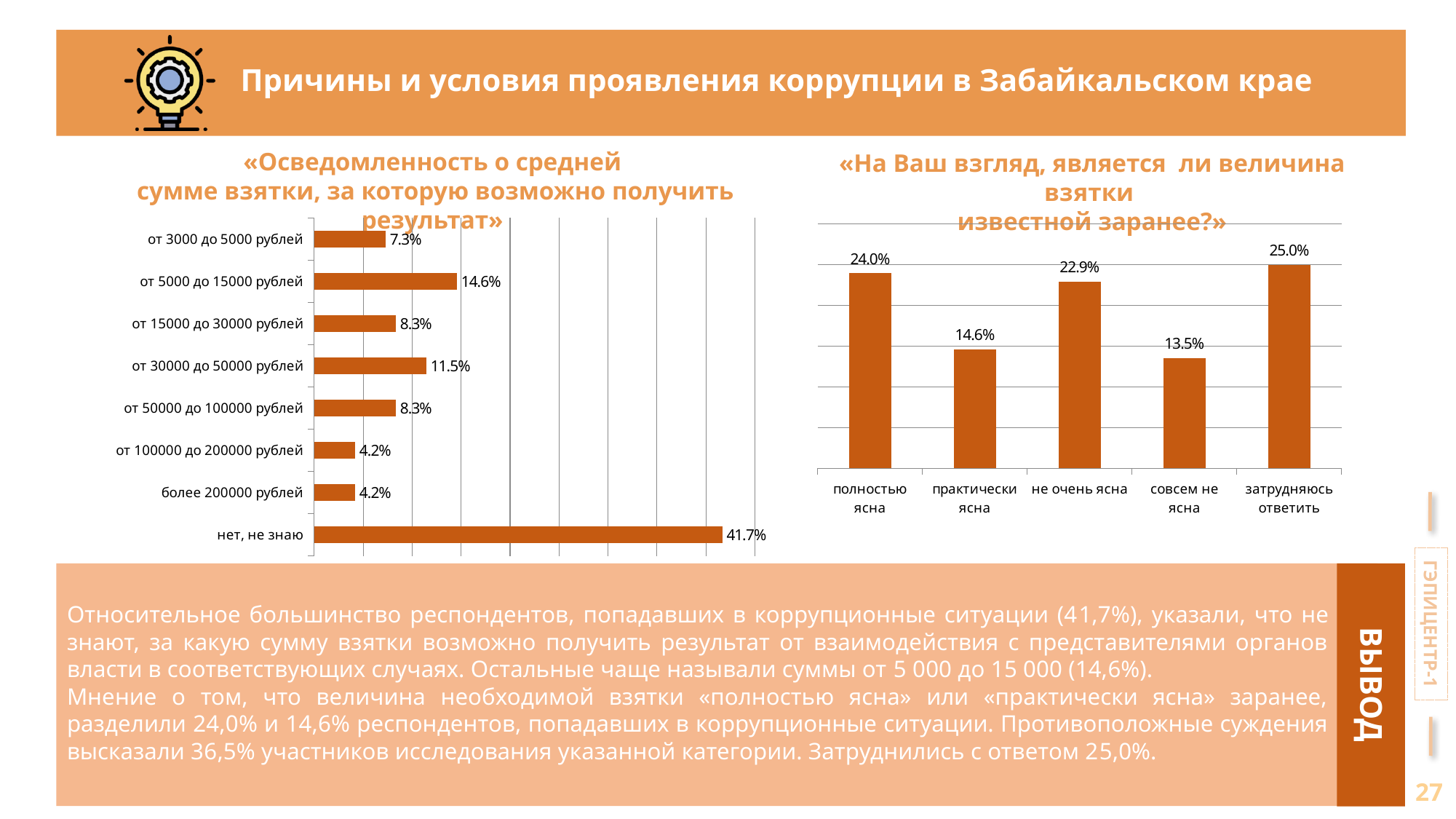
In the right chart («На Ваш взгляд, является ли величина взятки известной заранее?»), what is the value for «затрудняюсь ответить»? 25.0% In the right chart («На Ваш взгляд, является ли величина взятки известной заранее?»), what is the value for «не очень ясна»? 22.9% In the left chart («Осведомленность о средней сумме взятки...»), how many categories are shown? 8 In the right chart («На Ваш взгляд, является ли величина взятки известной заранее?»), how many categories are shown? 5 In the left chart («Осведомленность о средней сумме взятки...»), what is the value for «нет, не знаю»? 41.7% In the left chart («Осведомленность о средней сумме взятки...»), what is the difference between «от 30000 до 50000 рублей» and «от 3000 до 5000 рублей»? 4.2% In the right chart («На Ваш взгляд, является ли величина взятки известной заранее?»), what is the difference between «полностью ясна» and «практически ясна»? 9.4% In the left chart («Осведомленность о средней сумме взятки...»), which is larger: «от 5000 до 15000 рублей» or «от 15000 до 30000 рублей»? от 5000 до 15000 рублей In the left chart («Осведомленность о средней сумме взятки...»), which category has the highest value? нет, не знаю What kind of chart is the left chart («Осведомленность о средней сумме взятки...»)? bar chart In the right chart («На Ваш взгляд, является ли величина взятки известной заранее?»), which category has the lowest value? совсем не ясна In the left chart («Осведомленность о средней сумме взятки...»), what is the value for «от 5000 до 15000 рублей»? 14.6%